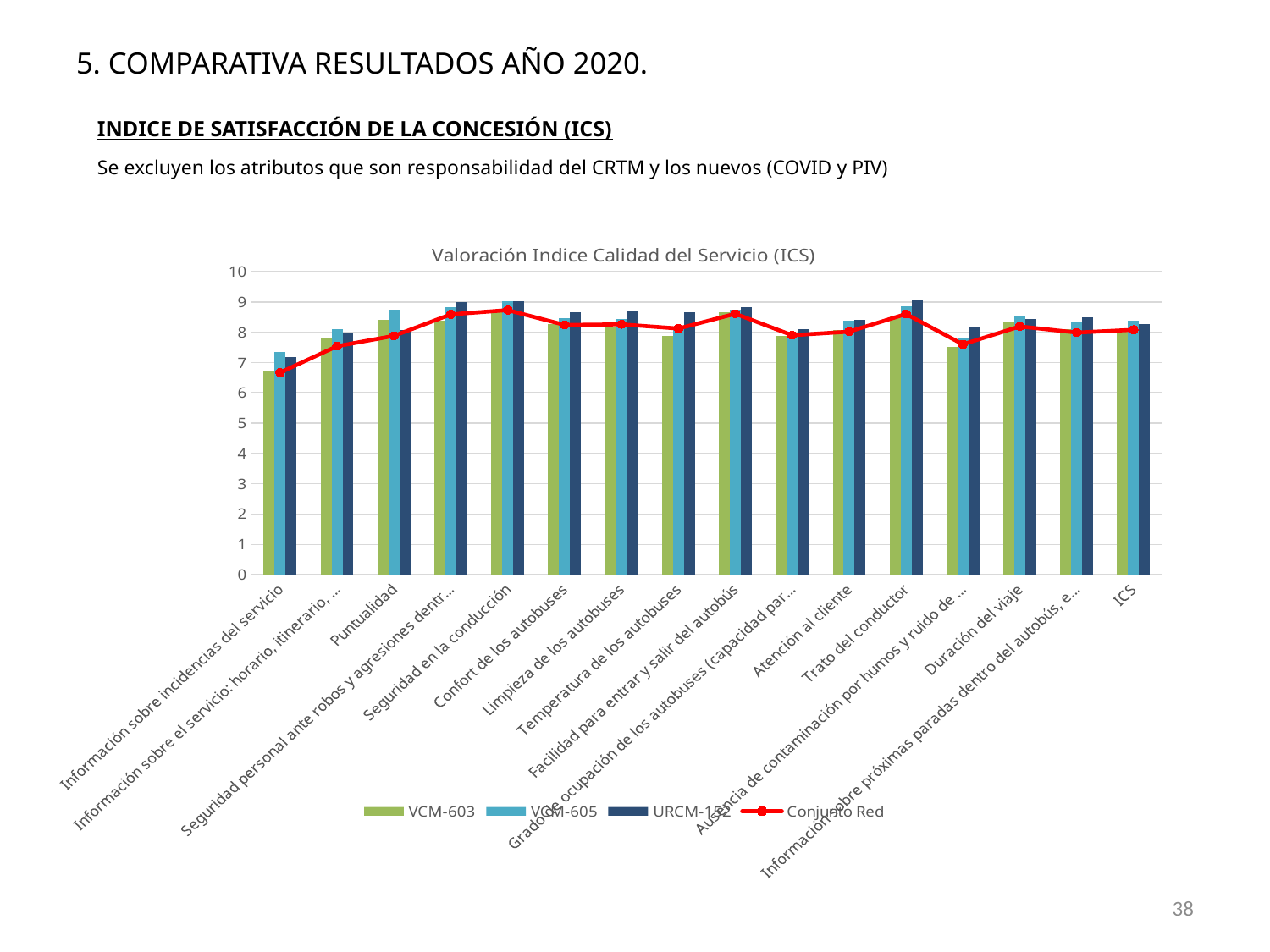
What kind of chart is shown on the slide? Bar chart combined with a line For which category is the VCM-603 value lowest? Información sobre incidencias del servicio For Información sobre incidencias del servicio, which is larger: the VCM-603 value or the VCM-605 value? VCM-605 For which category is the Conjunto Red value lowest? Información sobre incidencias del servicio Is the VCM-603 value for Ausencia de contaminación por humos y ruido greater or less than 8? less How many series does the chart legend list? 4 Is the VCM-603 value for Información sobre incidencias del servicio greater or less than 7? less What is the title of the chart? Valoración Indice Calidad del Servicio (ICS) For Puntualidad, which is larger: the VCM-603 value or the VCM-605 value? VCM-605 Which series is drawn as a red line with markers? Conjunto Red How many categories are shown on the x axis of the chart? 16